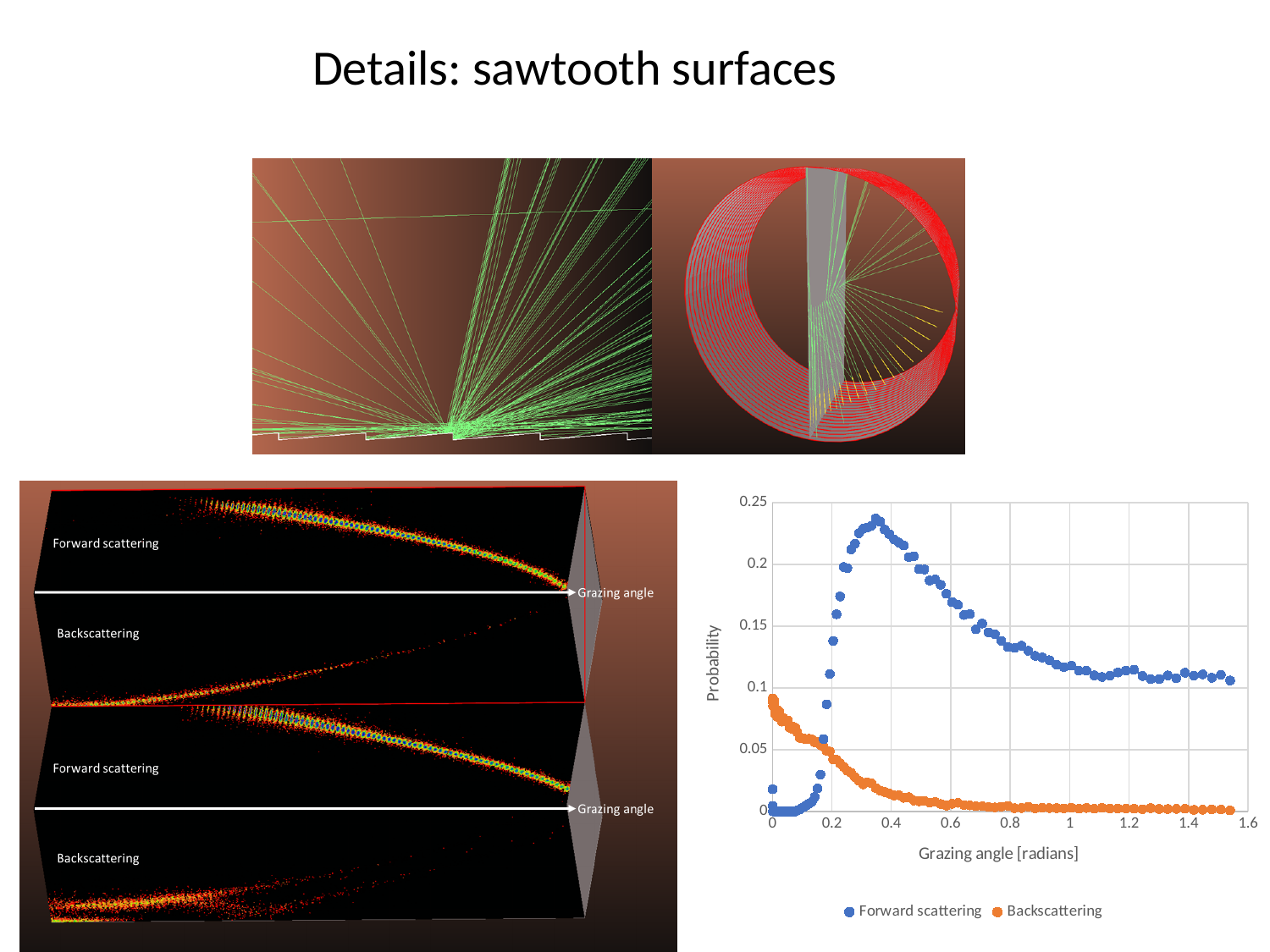
What are the two series named in the legend of the chart on the right? Forward scattering and Backscattering In the chart on the right, is the Backscattering value at a grazing angle of 1.0 greater or less than 0.05? less In the chart on the right, which series has the higher probability at a grazing angle of 0.4? Forward scattering In the chart on the right, is the Backscattering value at a grazing angle of 0 greater or less than 0.05? greater In the chart on the right, is the Forward scattering value at a grazing angle of 1.4 greater or less than 0.15? less In the chart on the right, does the Backscattering probability rise or fall as the grazing angle increases? fall What is the x-axis title of the chart on the right? Grazing angle [radians] In the chart on the right, which series has the higher probability at a grazing angle of about 0.05? Backscattering What kind of chart is shown on the right side of the slide? scatter chart How many series does the legend of the chart on the right list? 2 In the chart on the right, does the Forward scattering probability rise or fall between grazing angles of 0.4 and 1.0? fall